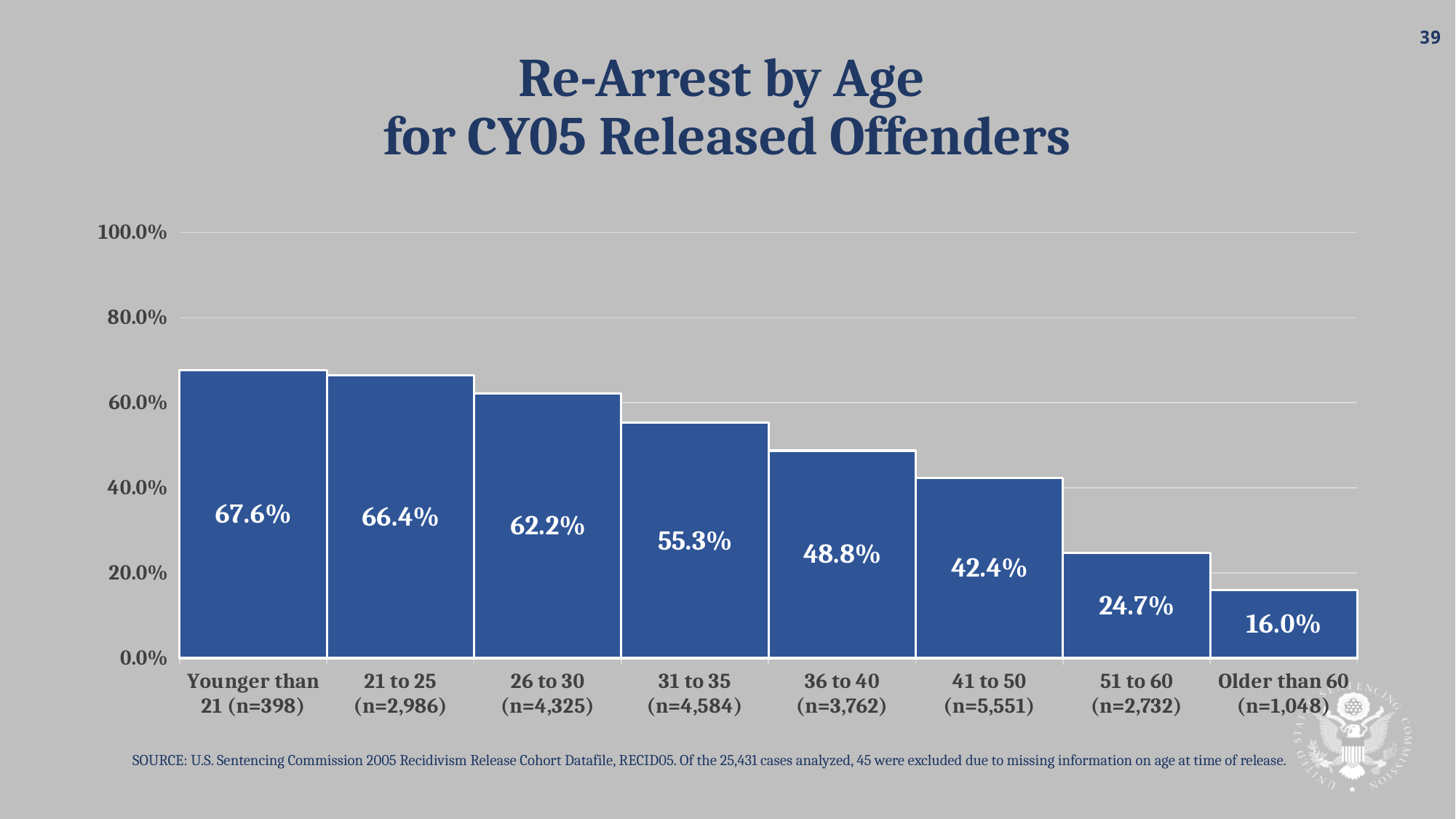
How many age groups are shown in the chart? 8 What is the difference in re-arrest rate between the 26 to 30 group and the 36 to 40 group? 13.4 percentage points What is the re-arrest rate for offenders aged 31 to 35? 55.3% Is the re-arrest rate for the 21 to 25 group greater or less than 60.0%? greater Which has a higher re-arrest rate, the 51 to 60 group or the 41 to 50 group? 41 to 50 What is the re-arrest rate for offenders older than 60? 16.0% What kind of chart is shown on the slide? Bar chart Do the re-arrest rates rise or fall as age increases along the x axis? Fall Which age group has the lowest re-arrest rate? Older than 60 What is the re-arrest rate for offenders aged 41 to 50? 42.4% What is the title of the chart? Re-Arrest by Age for CY05 Released Offenders Which age group has the highest re-arrest rate? Younger than 21